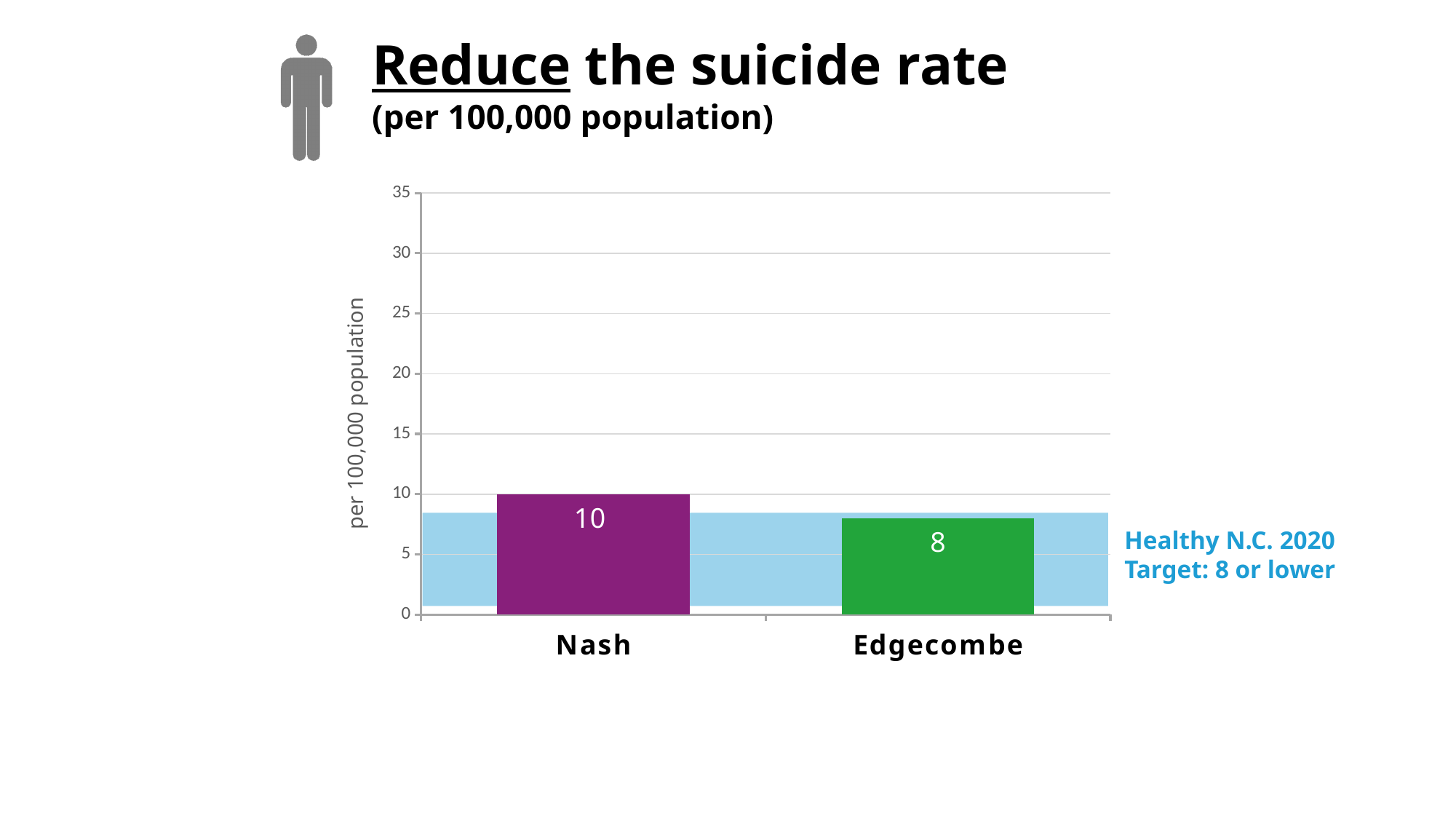
Which county has the higher suicide rate? Nash What kind of chart is shown on the slide? bar chart Which county has the lower suicide rate? Edgecombe Is the suicide rate for Nash greater or less than 15? less Is the suicide rate for Edgecombe greater or less than 5? greater What is the suicide rate for Nash? 10 What is the suicide rate for Edgecombe? 8 What is the difference between the suicide rates of Nash and Edgecombe? 2 How many counties are shown in the chart? 2 What is the label on the vertical axis of the chart? per 100,000 population What is the highest value shown on the vertical axis? 35 What is the Healthy N.C. 2020 target shown on the slide? 8 or lower